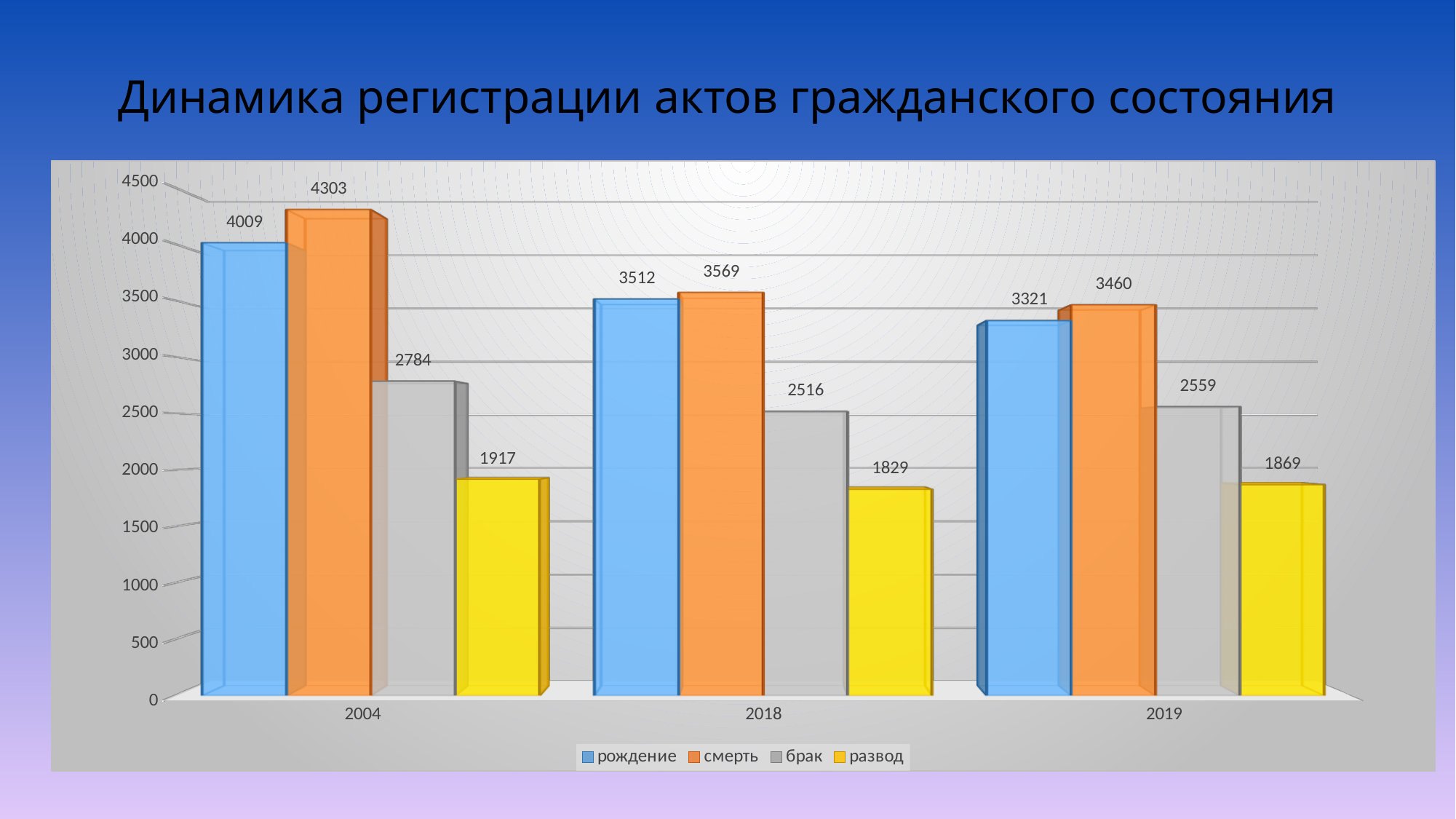
What is the value for рождение in 2004? 4009 How many years are shown on the x axis? 3 Which series has the lowest value in 2019? развод What kind of chart is shown on the slide? bar chart What is the value for смерть in 2018? 3569 How many series does the legend list? 4 What is the value for развод in 2018? 1829 Which year has the highest value for смерть? 2004 What is the title of the chart on the slide? Динамика регистрации актов гражданского состояния What is the difference between смерть and рождение in 2004? 294 What is the value for брак in 2019? 2559 Which is larger in 2019: рождение or смерть? смерть